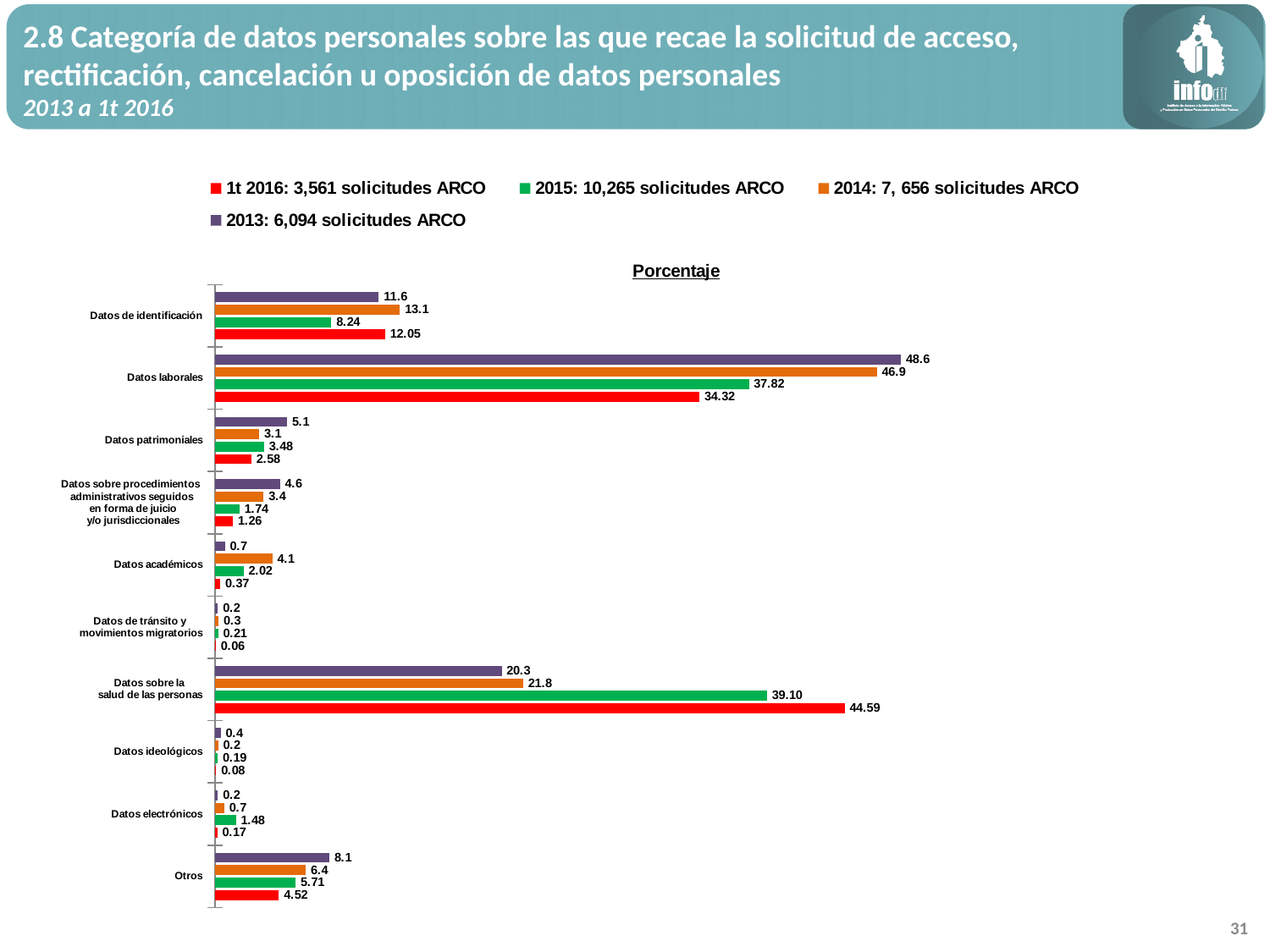
What is the 1t 2016 value for Datos sobre la salud de las personas? 44.59 How many series does the legend list? 4 What kind of chart is shown on the slide? Bar chart What is the 2014 value for Datos académicos? 4.1 Which category has the highest 2013 value? Datos laborales Which category has the lowest 1t 2016 value? Datos de tránsito y movimientos migratorios According to the legend, how many solicitudes ARCO were there in 2015? 10,265 For Datos sobre la salud de las personas, which is larger: the 2015 value or the 2014 value? 2015 What is the 2015 value for Datos laborales? 37.82 What is the difference between the 2013 and 1t 2016 values for Datos laborales? 14.28 How many categories are shown on the chart? 10 What is the 2013 value for Datos de identificación? 11.6